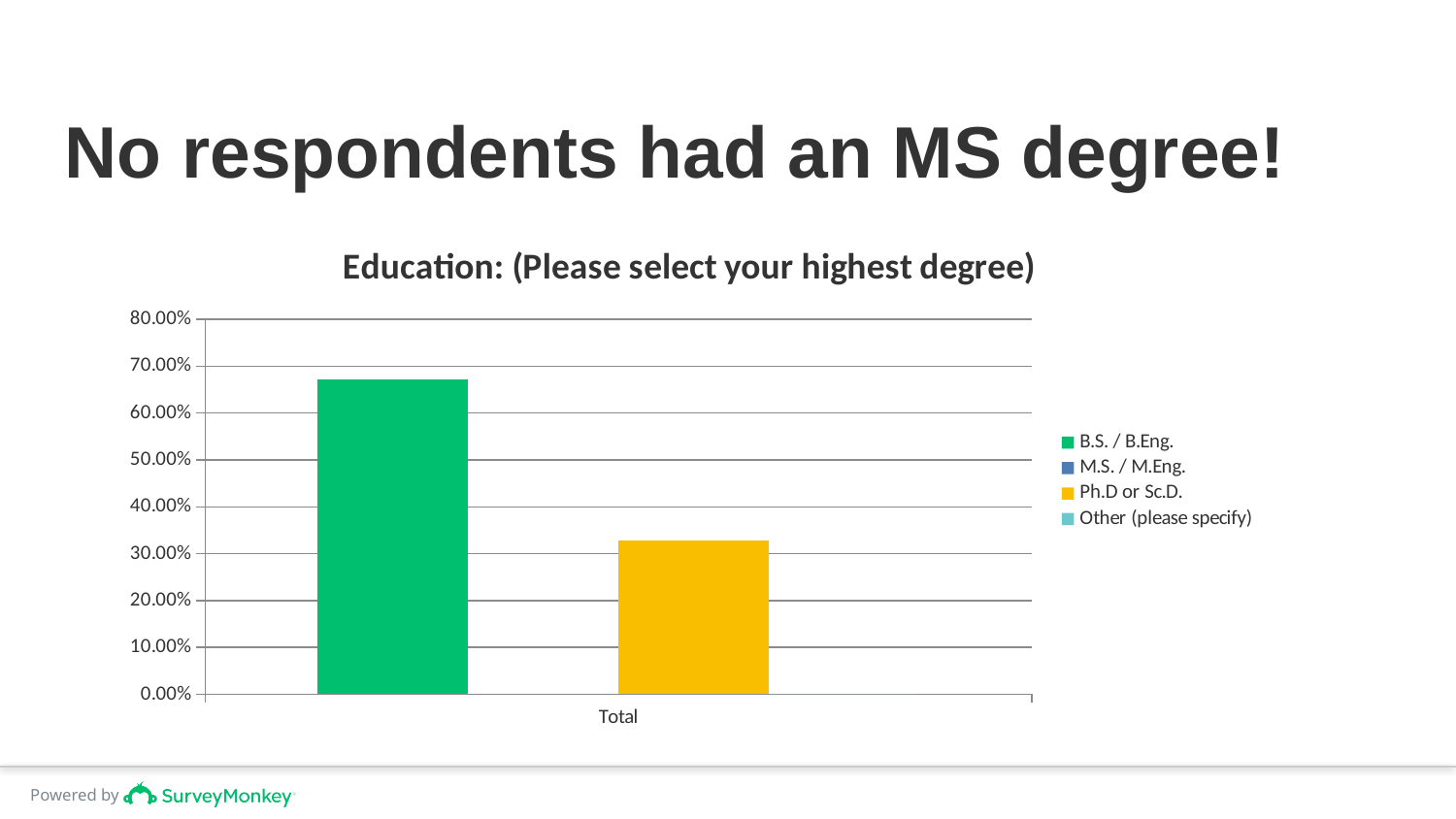
Is the value for Ph.D or Sc.D. greater or less than 20.00%? greater How many series does the legend list? 4 What kind of chart is shown on the slide? bar chart How many categories are shown on the x axis? 1 Is the value for B.S. / B.Eng. greater or less than 60.00%? greater Is the value for B.S. / B.Eng. greater or less than 70.00%? less Which is larger, the value for B.S. / B.Eng. or the value for Ph.D or Sc.D.? B.S. / B.Eng. What is the title of the chart? Education: (Please select your highest degree) What is the label of the category on the x axis? Total Which series has the tallest bar? B.S. / B.Eng.